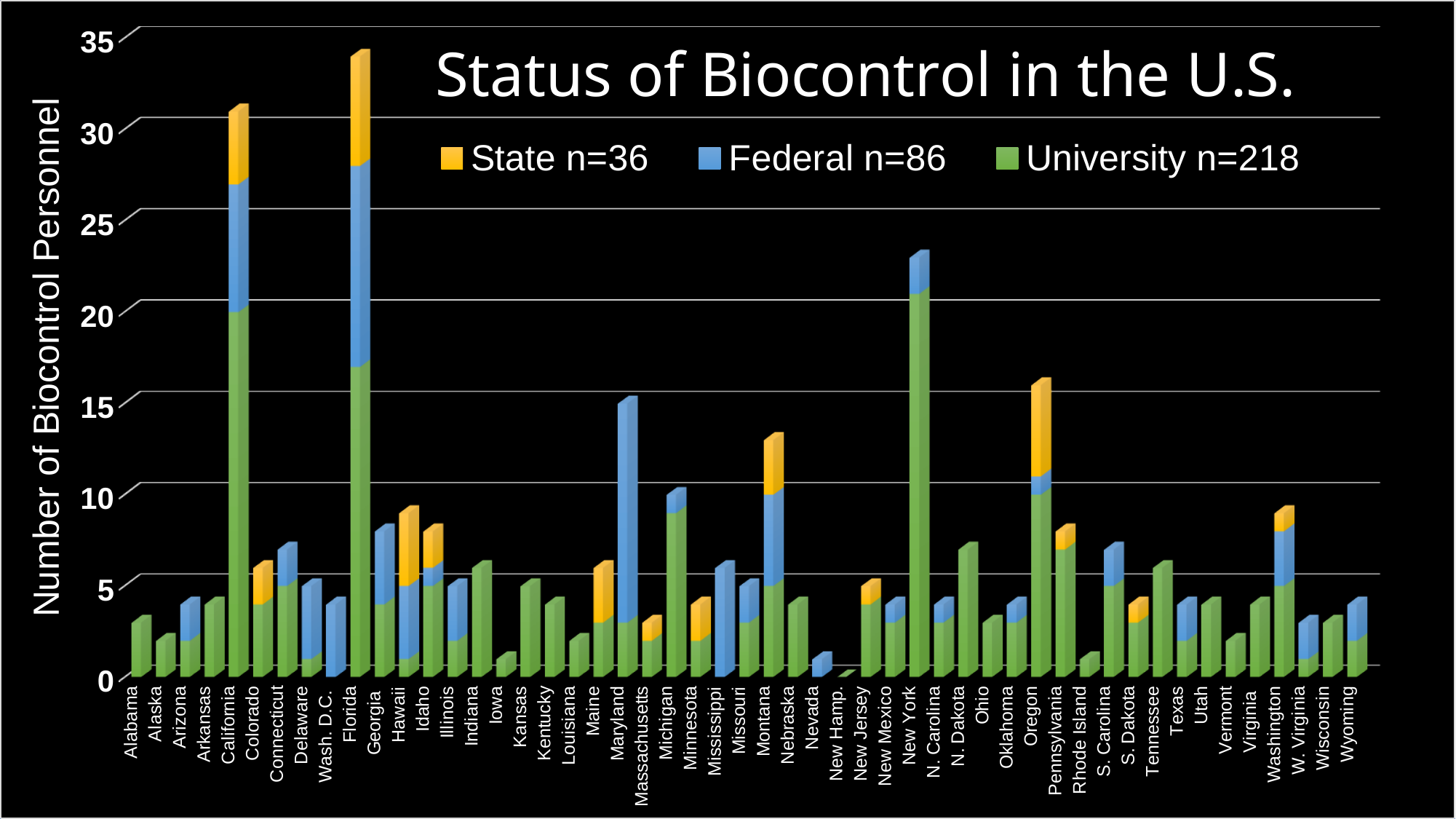
What kind of chart is shown on the slide? Stacked bar chart How many states/territories are shown along the x axis? 51 What is the title of the chart? Status of Biocontrol in the U.S. How many series does the legend list? 3 Is the total for Florida greater or less than 30? greater Which has a larger total, Oregon or Montana? Oregon Is the total for New York greater or less than 20? greater Which has a larger total, Florida or California? Florida According to the legend, what is the n value for the University series? n=218 Which state has the highest total number of biocontrol personnel? Florida Is the total for Indiana greater or less than 10? less